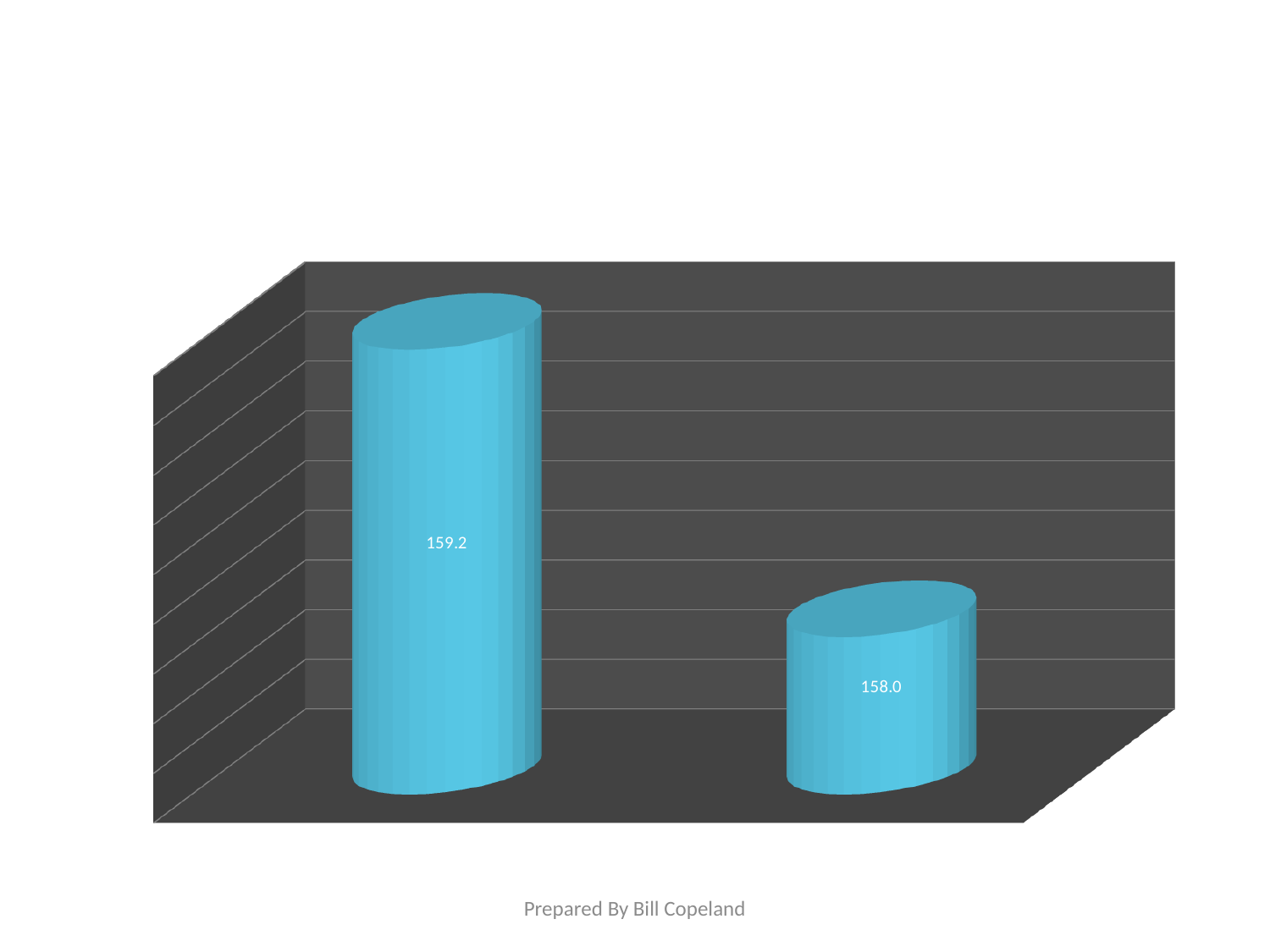
Do the values fall or rise from the left bar to the right bar? fall Which bar has the lower value, the left or the right? the right bar What value is printed on the left bar? 159.2 Is the value of the left bar larger or smaller than the value of the right bar? larger Which bar has the higher value, the left or the right? the left bar What colour are the bars on the chart? blue How many bars are plotted on the chart? 2 What kind of chart is shown on the slide? bar chart What value is printed on the right bar? 158.0 What text appears below the chart? Prepared By Bill Copeland What is the difference between the values of the left bar and the right bar? 1.2